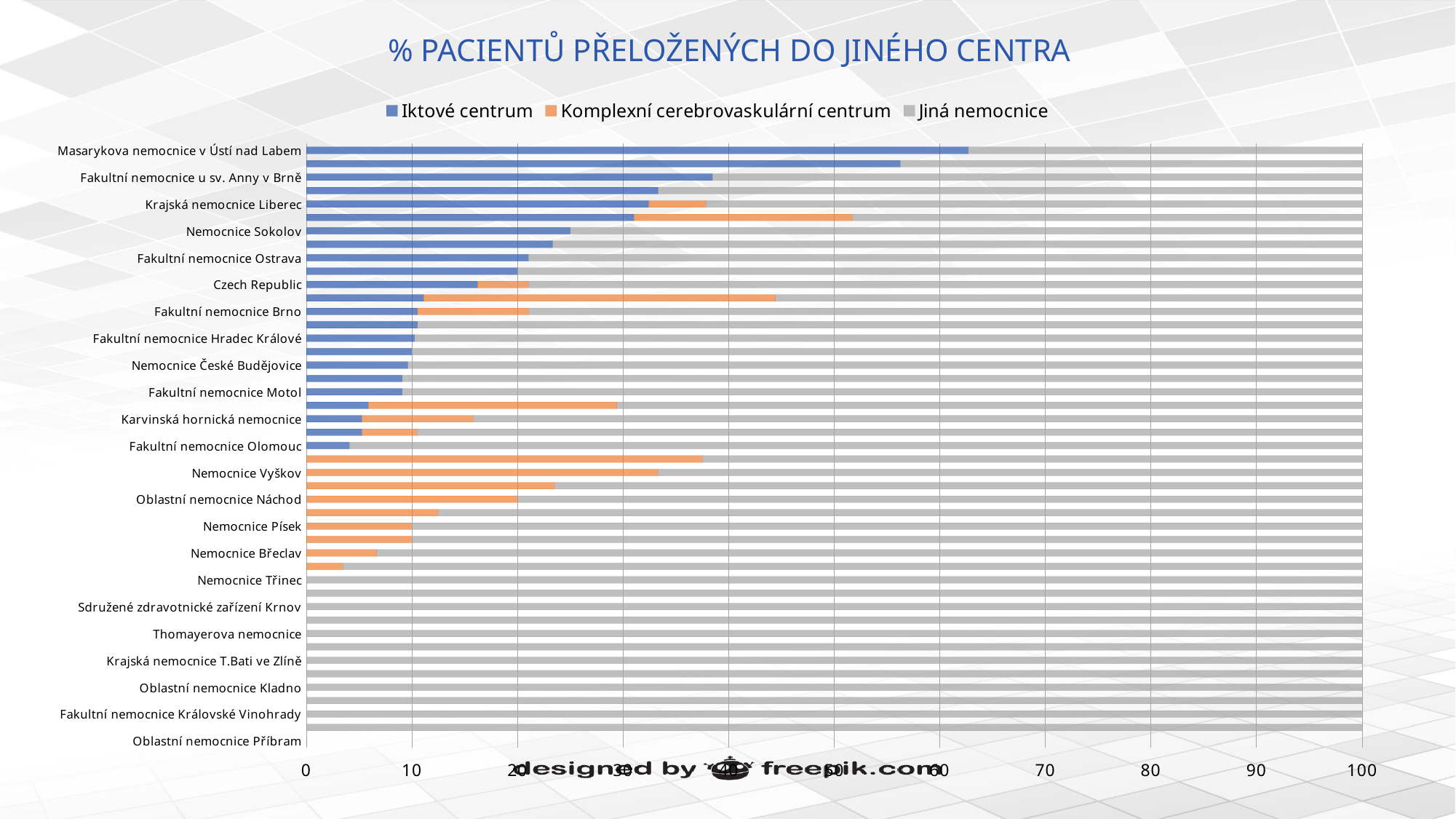
Which labelled hospital has the highest value for Iktové centrum? Masarykova nemocnice v Ústí nad Labem Which has the larger Iktové centrum value: Nemocnice Sokolov or Fakultní nemocnice Ostrava? Nemocnice Sokolov How many series does the legend list? 3 Is the Iktové centrum value for Masarykova nemocnice v Ústí nad Labem greater or less than 60? greater What kind of chart is shown on the slide? Bar chart Which has the larger Komplexní cerebrovaskulární centrum value: Nemocnice Vyškov or Oblastní nemocnice Náchod? Nemocnice Vyškov Which colour represents the series "Jiná nemocnice" in the legend? Gray Is the Komplexní cerebrovaskulární centrum value for Nemocnice Vyškov greater or less than 30? greater What is the title of the chart? % PACIENTŮ PŘELOŽENÝCH DO JINÉHO CENTRA Is the Iktové centrum value for Fakultní nemocnice Olomouc greater or less than 10? less